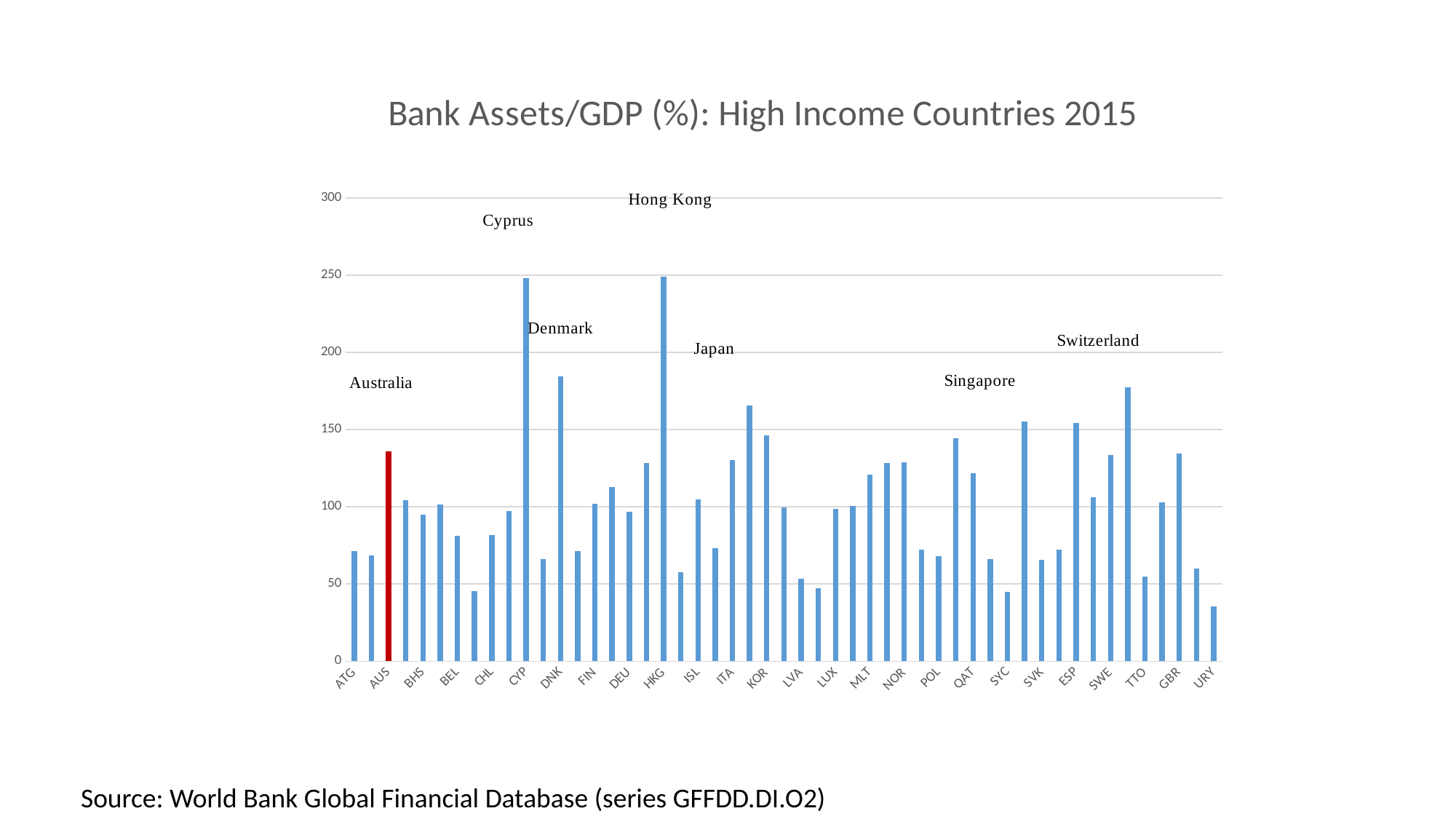
Is the value for POL greater or less than 100? less Which country has the lowest bank assets/GDP value? URY Which country's bar is highlighted in red? AUS Is the value for DNK greater or less than 150? greater Which has a higher value, DNK or SWE? DNK Is the value for CYP greater or less than 200? greater What type of chart is shown on the slide? bar chart Which has a higher value, HKG or KOR? HKG Which has a higher value, CYP or DNK? CYP What is the title of the chart? Bank Assets/GDP (%): High Income Countries 2015